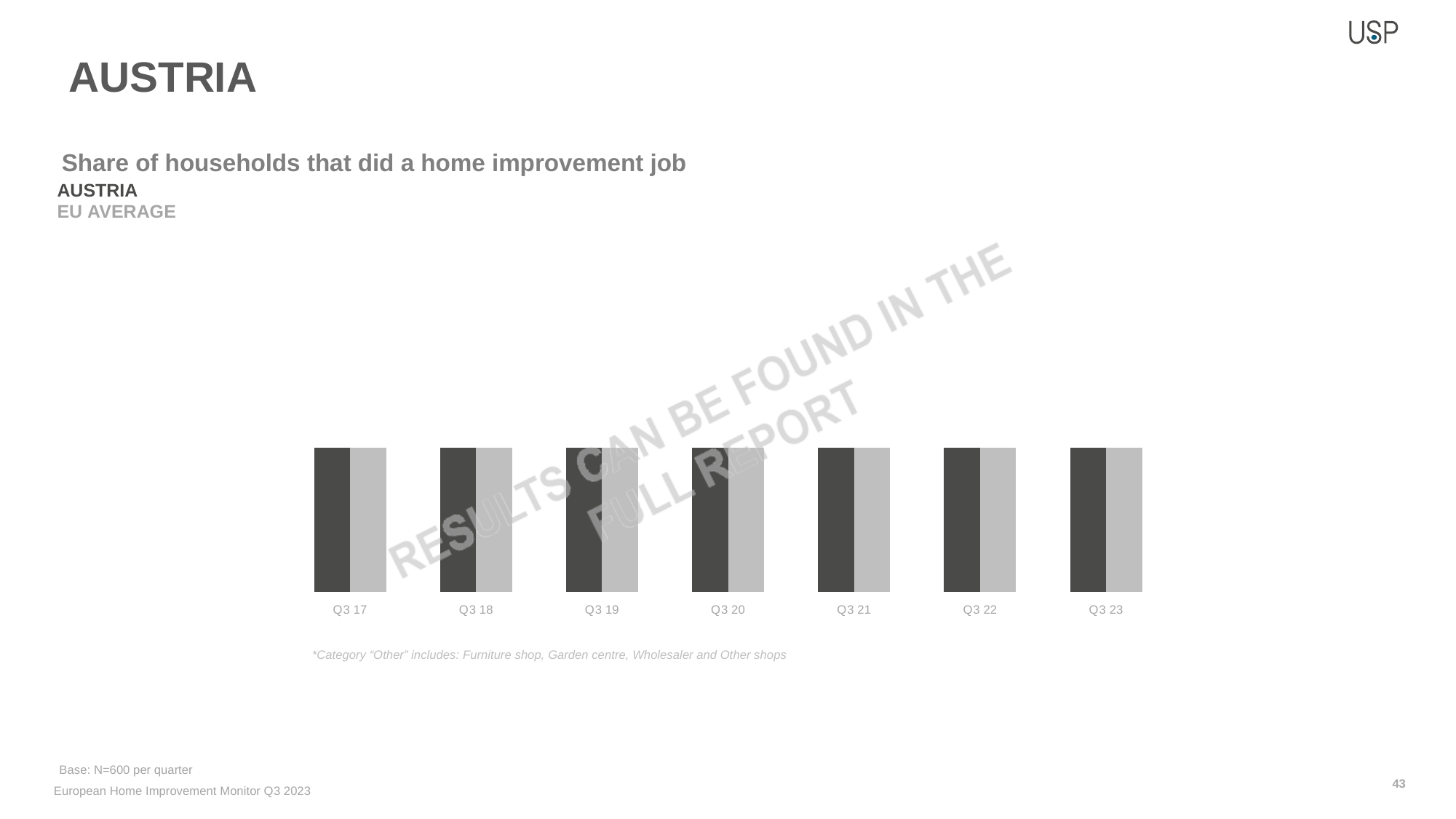
How many quarters are shown along the x axis of the chart? 7 What kind of chart is shown on the slide? Bar chart What is the title of the chart? Share of households that did a home improvement job Which two series are listed in the chart's legend? AUSTRIA and EU AVERAGE How many series does the chart's legend list? 2 What is the first category label on the x axis of the chart? Q3 17 What is the last category label on the x axis of the chart? Q3 23